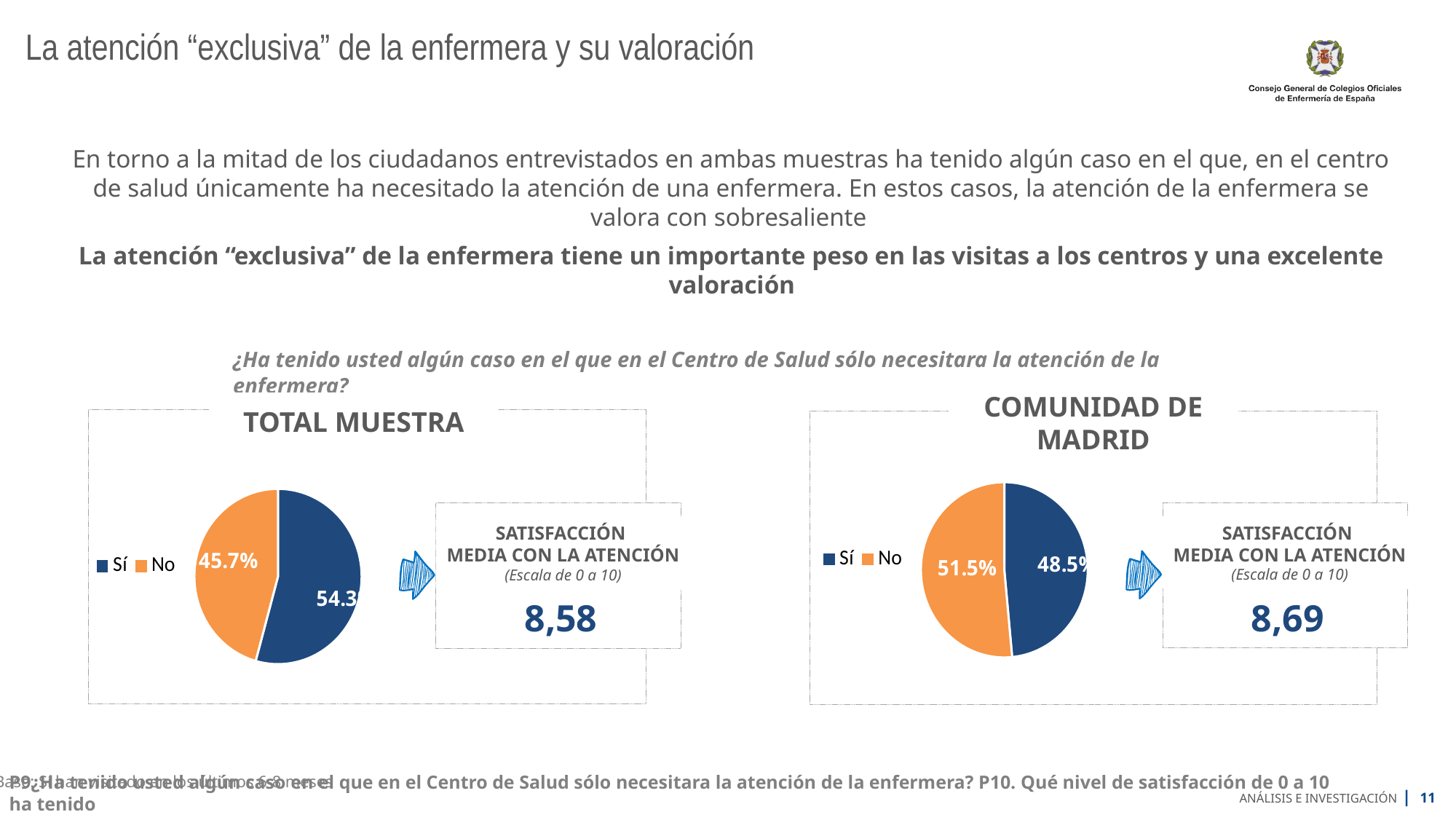
In the COMUNIDAD DE MADRID pie chart, which slice is larger, Sí or No? No In the COMUNIDAD DE MADRID pie chart, what percentage is shown for No? 51.5% What type of chart is used for TOTAL MUESTRA? Pie chart In the COMUNIDAD DE MADRID pie chart, what percentage is shown for Sí? 48.5% What is the title of the pie chart on the left of the slide? TOTAL MUESTRA In the COMUNIDAD DE MADRID pie chart, what colour is the Sí slice? Dark blue In the TOTAL MUESTRA pie chart, what percentage is shown for No? 45.7% In the COMUNIDAD DE MADRID pie chart, what is the difference between the No and Sí percentages? 3.0% In the TOTAL MUESTRA pie chart, is the value for No greater or less than 50%? less How many entries does the legend of the TOTAL MUESTRA pie chart list? 2 In the TOTAL MUESTRA pie chart, which slice is larger, Sí or No? Sí How many slices does the COMUNIDAD DE MADRID pie chart have? 2